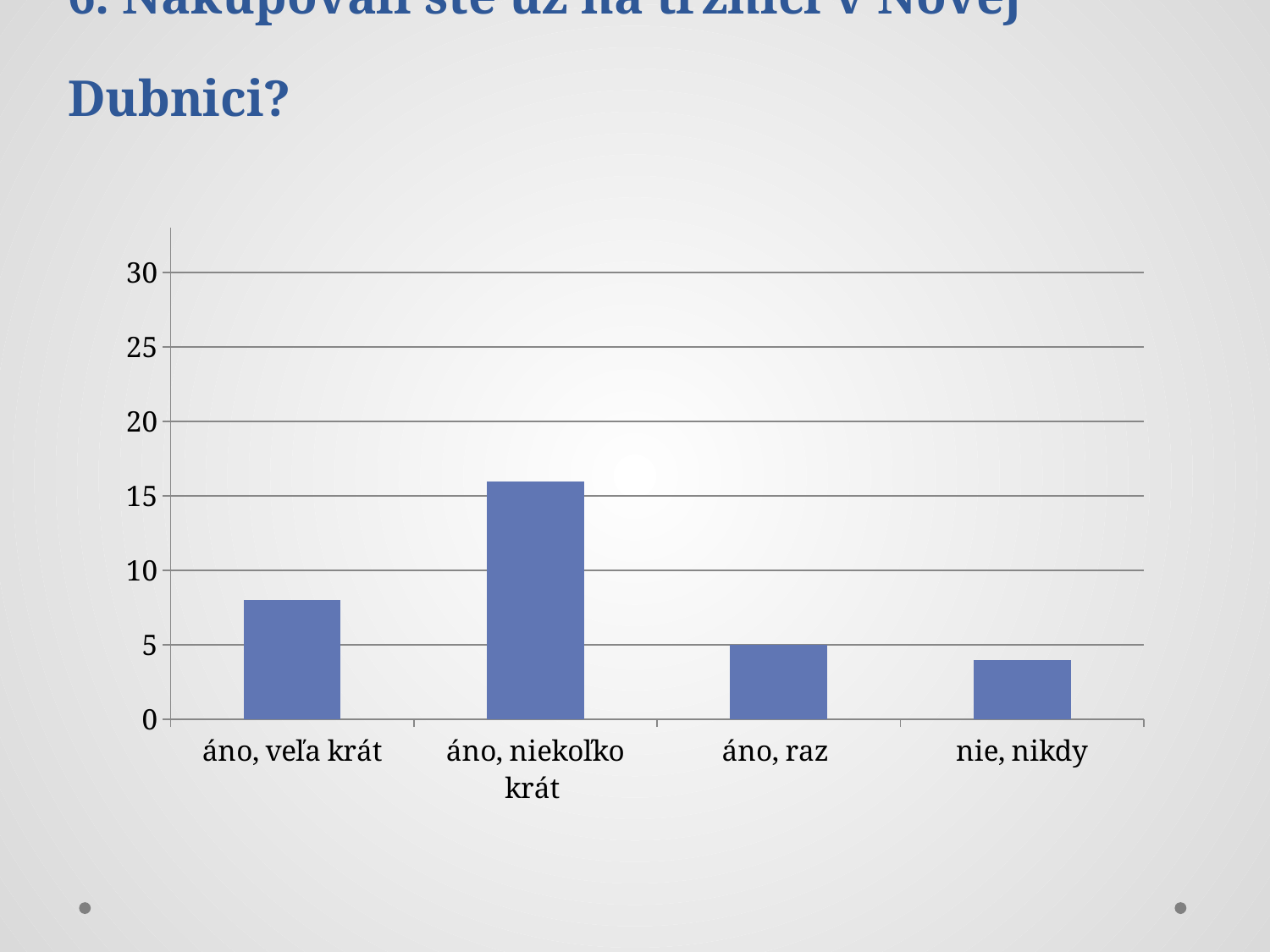
Is the value for "áno, veľa krát" greater or less than 10? less How many categories are shown on the x axis of the chart? 4 Is the value for "nie, nikdy" greater or less than 5? less Which category has the highest bar in the chart? áno, niekoľko krát What kind of chart is shown on the slide? bar chart Which is larger, the value for "áno, niekoľko krát" or the value for "nie, nikdy"? áno, niekoľko krát Which category has the lowest bar in the chart? nie, nikdy Is the value for "áno, niekoľko krát" greater or less than 20? less What is the value for "áno, raz" in the chart? 5 Which is larger, the value for "áno, veľa krát" or the value for "áno, raz"? áno, veľa krát